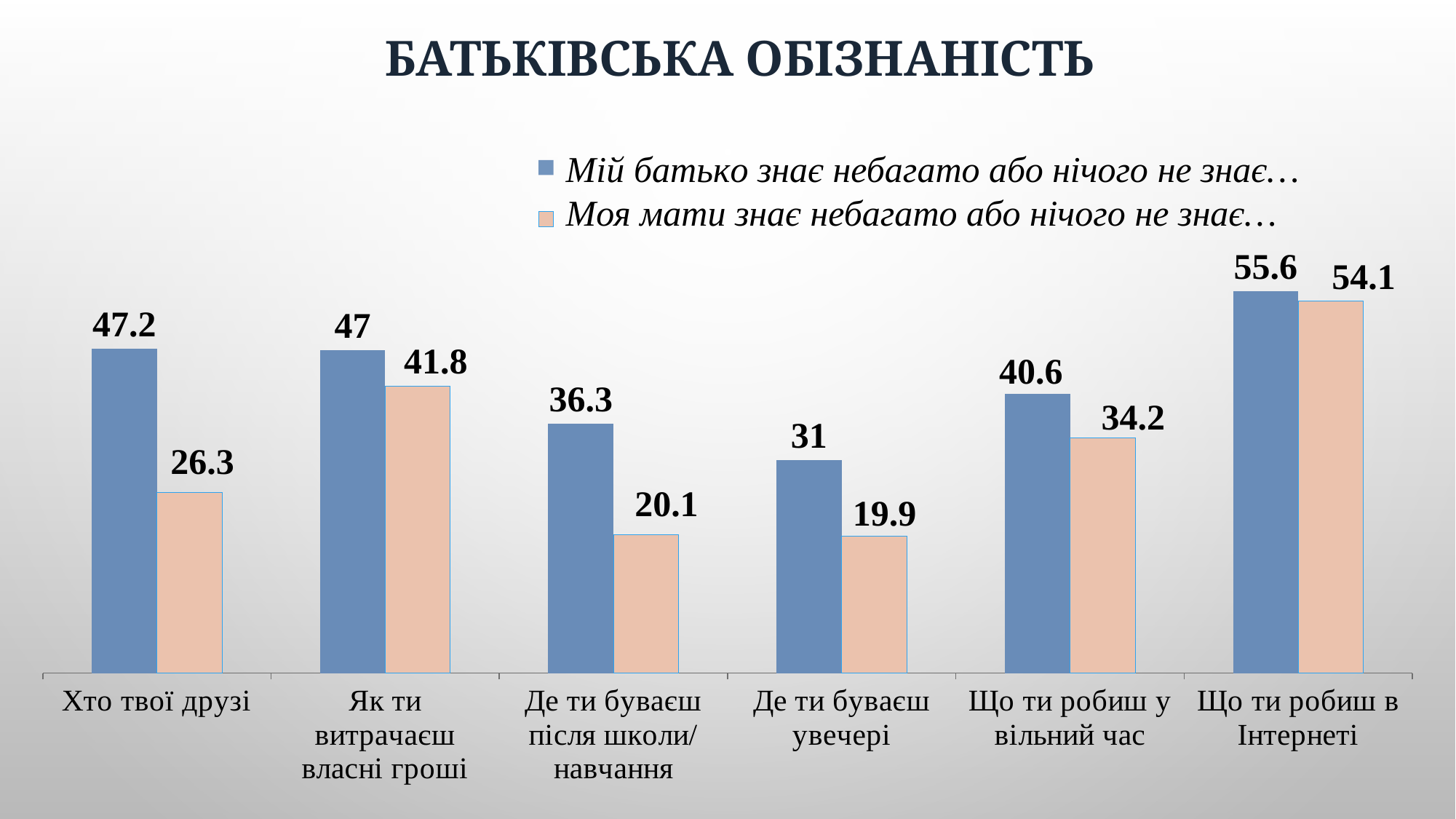
How many categories are shown on the x axis? 6 What value is shown for the mother series for the category "Що ти робиш у вільний час"? 34.2 What is the title of the slide? БАТЬКІВСЬКА ОБІЗНАНІСТЬ How many series does the legend list? 2 What is the difference between the father and mother values for the category "Хто твої друзі"? 20.9 Which category has the lowest value for the mother series? Де ти буваєш увечері What value is shown for the father series ("Мій батько знає небагато або нічого не знає…") for the category "Хто твої друзі"? 47.2 What is the difference between the father and mother values for the category "Що ти робиш в Інтернеті"? 1.5 What value is shown for the mother series ("Моя мати знає небагато або нічого не знає…") for the category "Де ти буваєш увечері"? 19.9 What kind of chart is shown on the slide? Bar chart For the category "Де ти буваєш після школи/навчання", which series has the larger value, father or mother? Father (Мій батько знає небагато або нічого не знає…) Which category has the highest value for the father series? Що ти робиш в Інтернеті